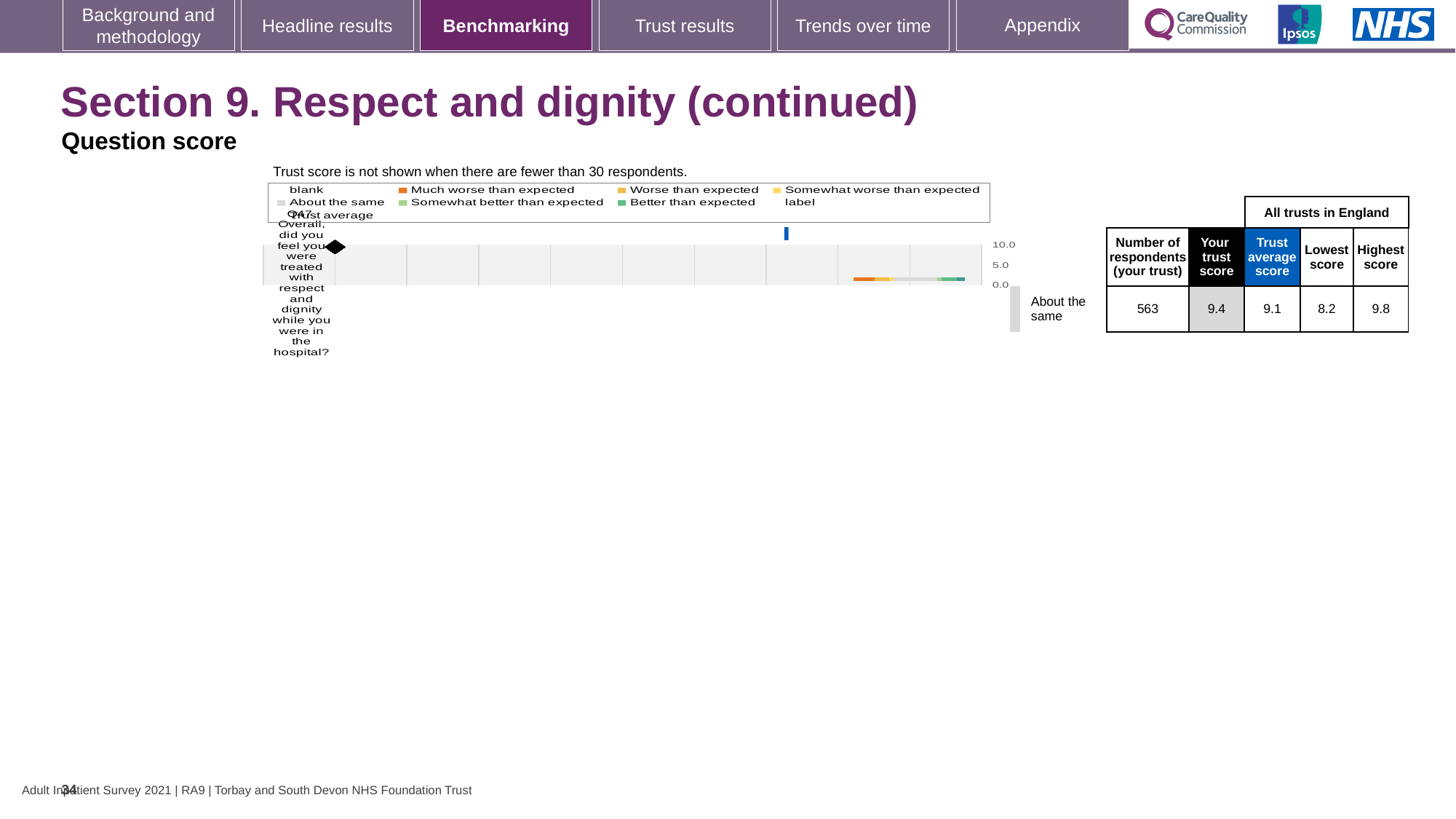
What kind of chart is shown on the slide? bar chart What is the highest value shown on the chart's numeric axis? 10.0 What is the trust average score for all trusts in England shown next to the chart? 9.1 What is the difference between the highest score and the lowest score among all trusts in England? 1.6 Which is larger, your trust score or the trust average score? your trust score What is the highest score among all trusts in England shown next to the chart? 9.8 What benchmark category label is shown for the trust's result on this question? About the same What is the trust score shown for the question 'Overall, did you feel you were treated with respect and dignity while you were in the hospital?' 9.4 What is the number of respondents for your trust shown next to the chart? 563 How many question categories are plotted on the chart? 1 What is the lowest score among all trusts in England shown next to the chart? 8.2 What is the difference between your trust score and the trust average score? 0.3